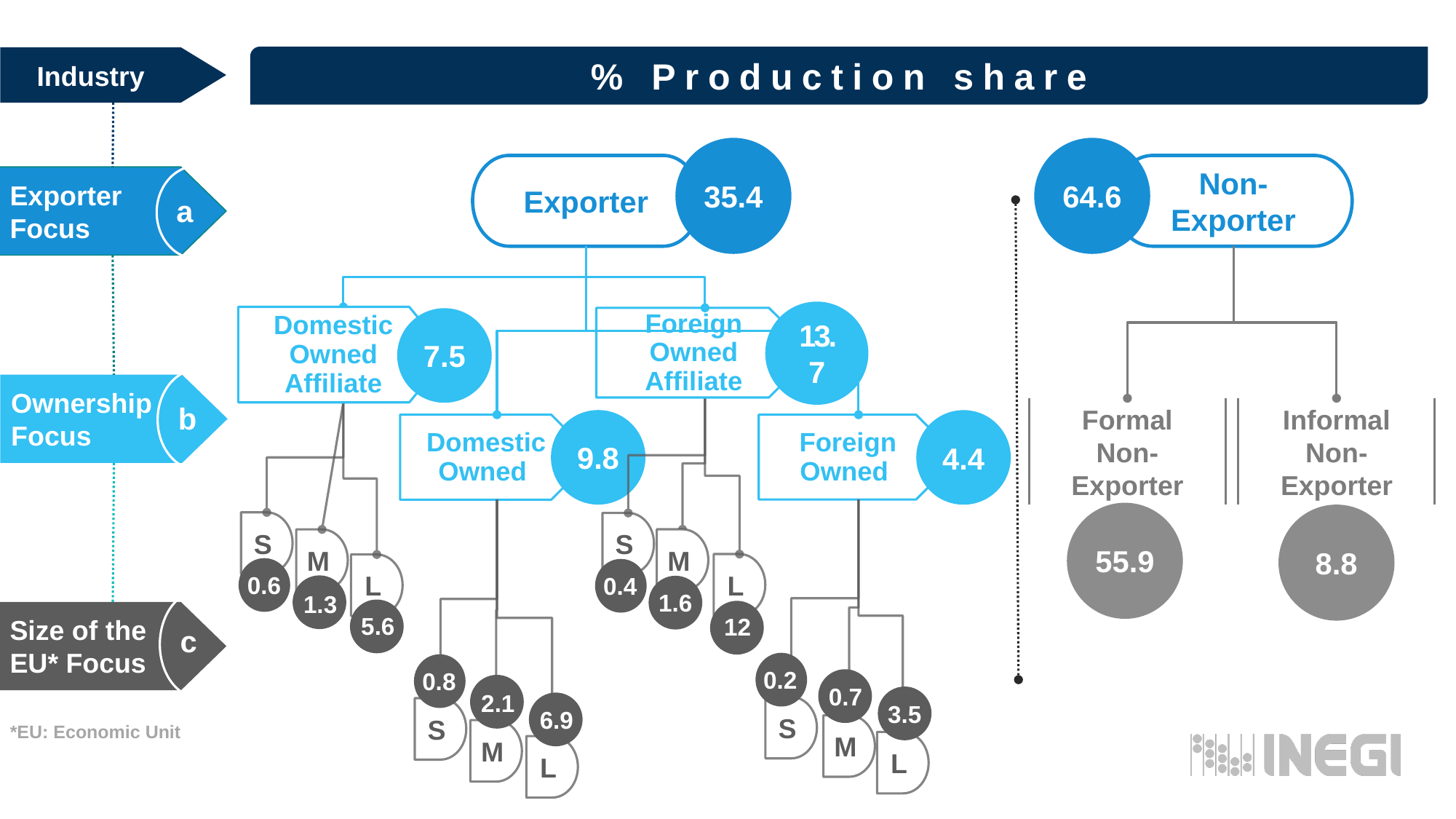
What is the production share for Non-Exporter? 64.6 What is the production share for Foreign Owned Affiliate? 13.7 Which has a larger production share, Domestic Owned or Domestic Owned Affiliate? Domestic Owned What is the production share for Exporter? 35.4 Which of the four ownership categories under Exporter has the highest production share? Foreign Owned Affiliate Which of the four ownership categories under Exporter has the lowest production share? Foreign Owned What is the difference in production share between Non-Exporter and Exporter? 29.2 What is the difference in production share between Formal Non-Exporter and Informal Non-Exporter? 47.1 What is the production share for Formal Non-Exporter? 55.9 What is the title of the chart? % Production share What is the production share for large (L) economic units under Foreign Owned Affiliate? 12 How many ownership categories are shown under Exporter? 4